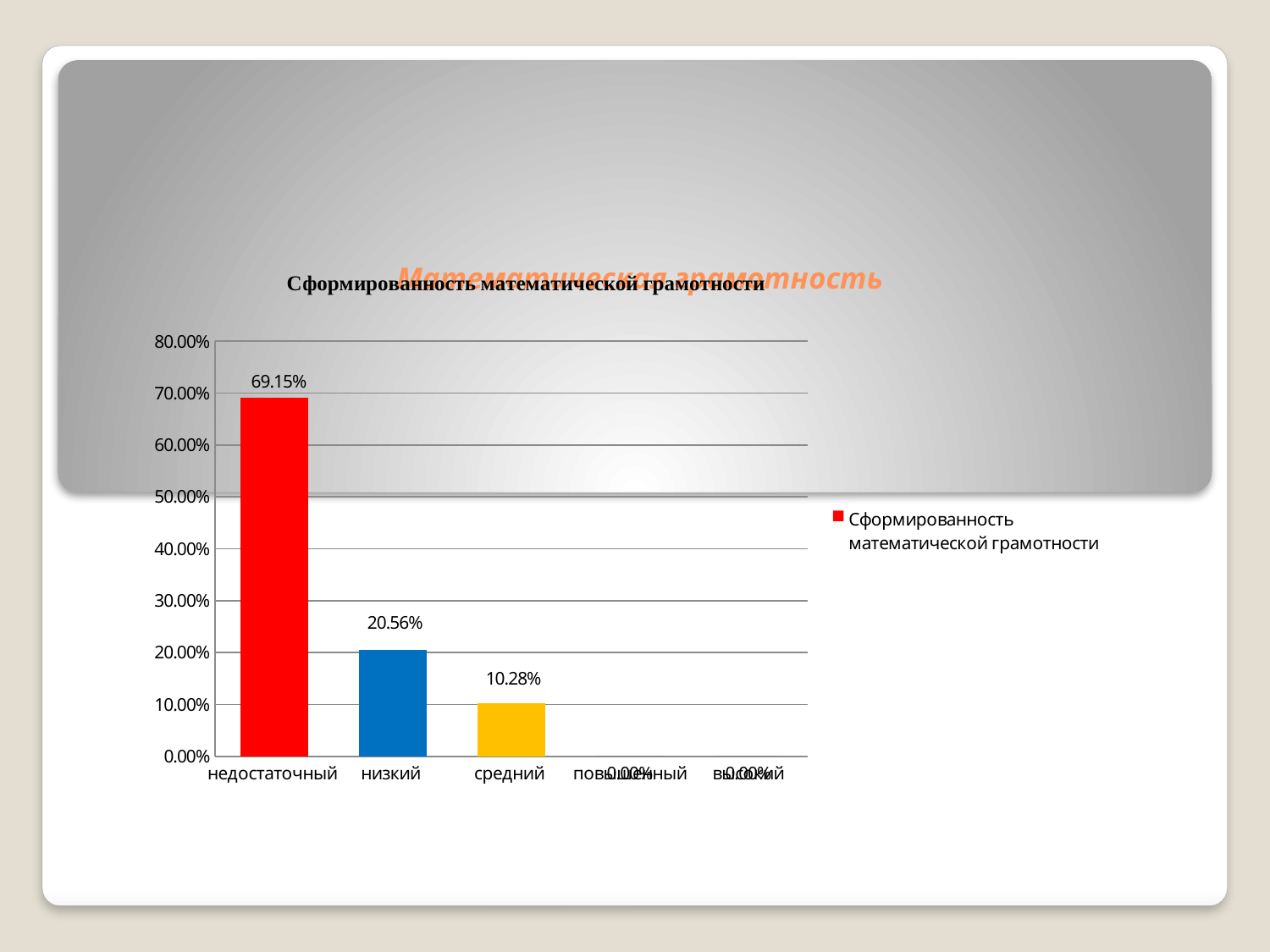
What is the difference between the values for низкий and средний? 10.28% How many categories are shown on the x axis? 5 What kind of chart is shown on the slide? bar chart How many series does the legend list? 1 Which category has the highest value? недостаточный Which is larger, the value for низкий or the value for средний? низкий Is the value for недостаточный greater or less than 60.00%? greater What is the value for недостаточный? 69.15% What is the title of the chart? Сформированность математической грамотности What is the difference between the values for недостаточный and низкий? 48.59% What is the value for средний? 10.28% What is the value for низкий? 20.56%